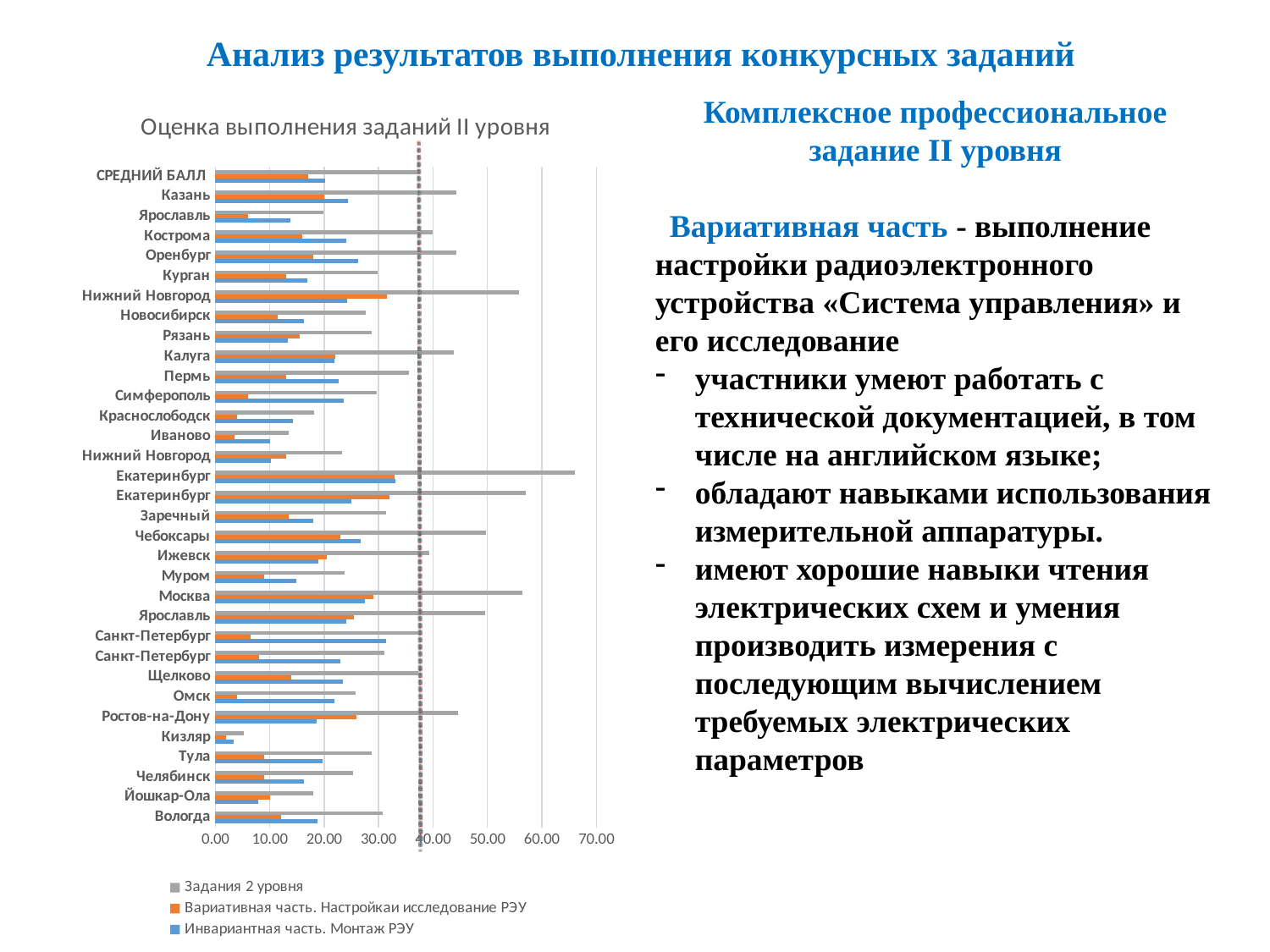
What kind of chart is shown on the slide? bar chart How many series does the chart legend list? 3 What is the highest tick value shown on the chart's horizontal axis? 70.00 Which has the larger 'Задания 2 уровня' value, Казань or Ярославль (the one listed directly below Казань)? Казань Which category has the lowest value for the series 'Задания 2 уровня'? Кизляр Which category has the highest value for the series 'Задания 2 уровня'? Екатеринбург How many categories are plotted on the chart's vertical axis? 33 What is the title of the chart? Оценка выполнения заданий II уровня Is the 'Задания 2 уровня' value for Москва greater or less than 50.00? greater Is the 'Задания 2 уровня' value for Иваново greater or less than 20.00? less Is the 'Задания 2 уровня' value for Кизляр greater or less than 10.00? less Which has the larger 'Вариативная часть. Настройкаи исследование РЭУ' value, Иваново or Ростов-на-Дону? Ростов-на-Дону